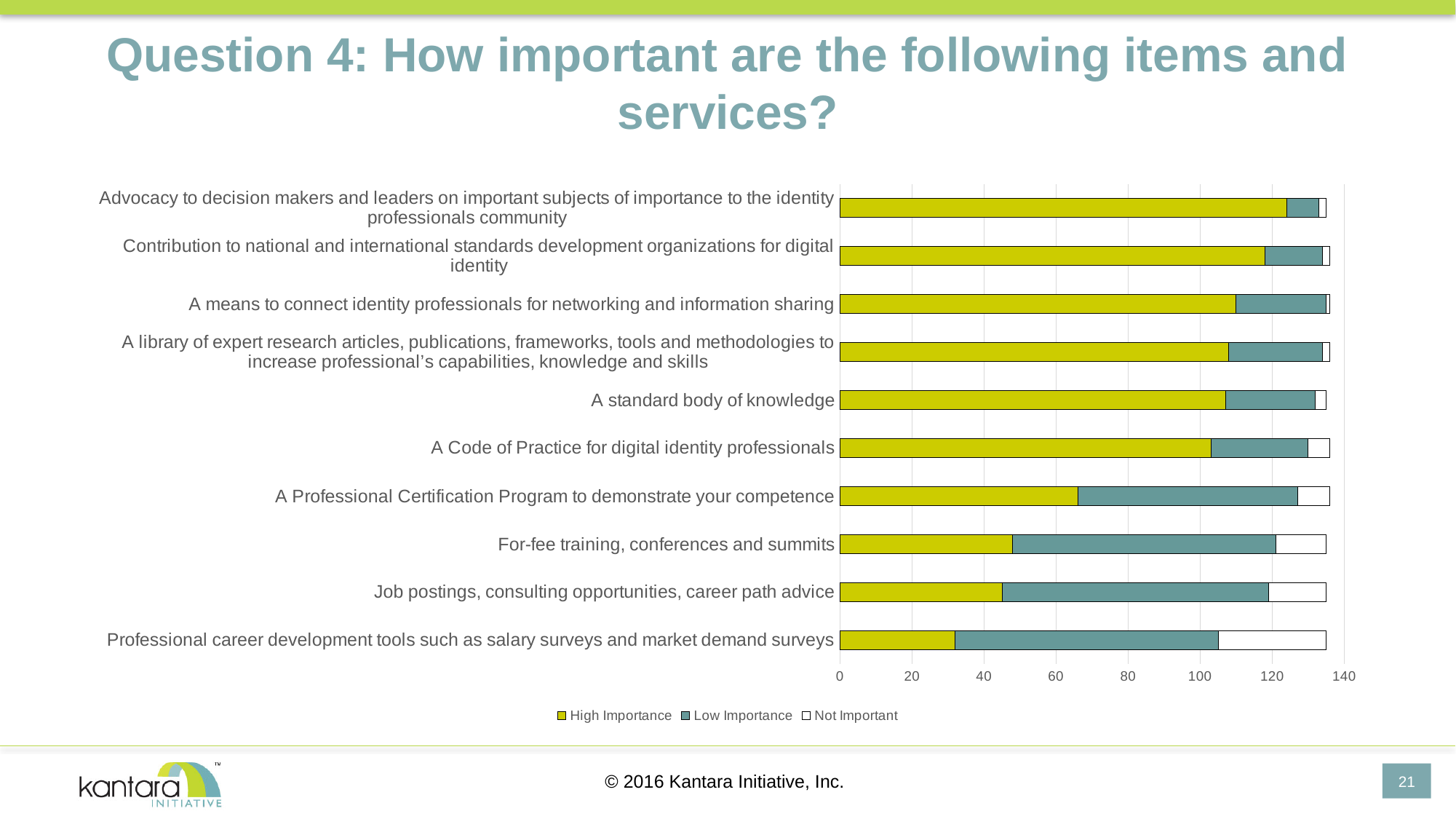
Which item has the lowest High Importance value? Professional career development tools such as salary surveys and market demand surveys Which item has the highest High Importance value? Advocacy to decision makers and leaders on important subjects of importance to the identity professionals community Is the High Importance value for 'Advocacy to decision makers and leaders on important subjects of importance to the identity professionals community' greater or less than 100? greater Is the High Importance value for 'Professional career development tools such as salary surveys and market demand surveys' greater or less than 40? less Reading the categories from top to bottom, does the High Importance value rise or fall? Fall Which has the larger High Importance value: 'A Code of Practice for digital identity professionals' or 'A Professional Certification Program to demonstrate your competence'? A Code of Practice for digital identity professionals What kind of chart is shown on the slide? Stacked bar chart How many items or services are listed as categories in the chart? 10 Is the High Importance value for 'A Professional Certification Program to demonstrate your competence' greater or less than 60? greater Which series are listed in the legend? High Importance, Low Importance, Not Important How many series does the legend list? 3